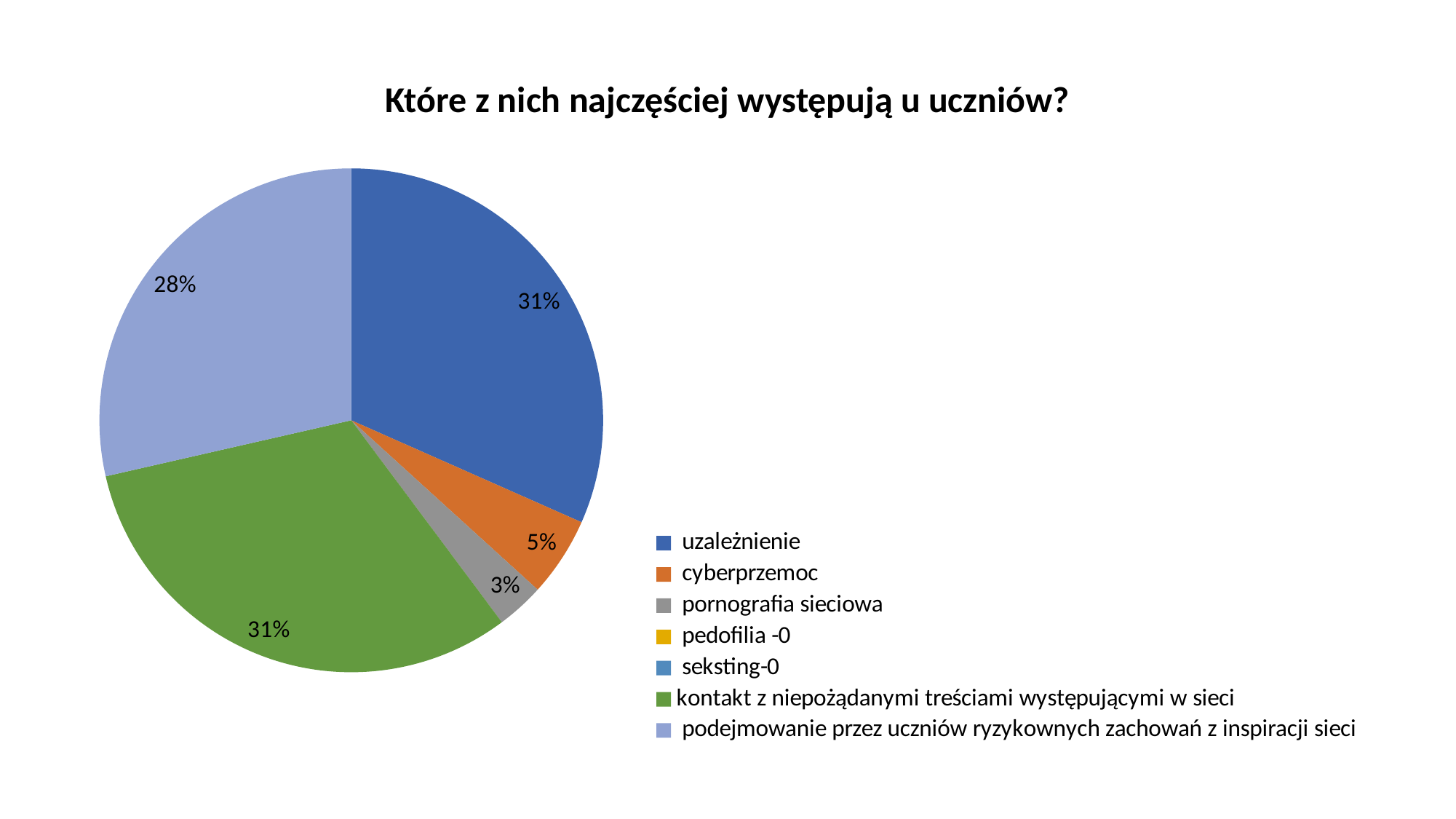
What percentage of the pie is the slice for cyberprzemoc? 5% What is the difference in percentage points between the uzależnienie slice and the podejmowanie przez uczniów ryzykownych zachowań z inspiracji sieci slice? 3 percentage points What percentage of the pie is the slice for kontakt z niepożądanymi treściami występującymi w sieci? 31% What percentage of the pie is the slice for pornografia sieciowa? 3% What percentage of the pie is the slice for podejmowanie przez uczniów ryzykownych zachowań z inspiracji sieci? 28% What is the difference in percentage points between the cyberprzemoc slice and the pornografia sieciowa slice? 2 percentage points What percentage of the pie is the slice for uzależnienie? 31% What type of chart is shown on the slide? pie chart How many entries does the legend list? 7 What is the title of the chart? Które z nich najczęściej występują u uczniów? Which slice is larger, cyberprzemoc or pornografia sieciowa? cyberprzemoc Which legend entries are marked with a value of 0? pedofilia and seksting